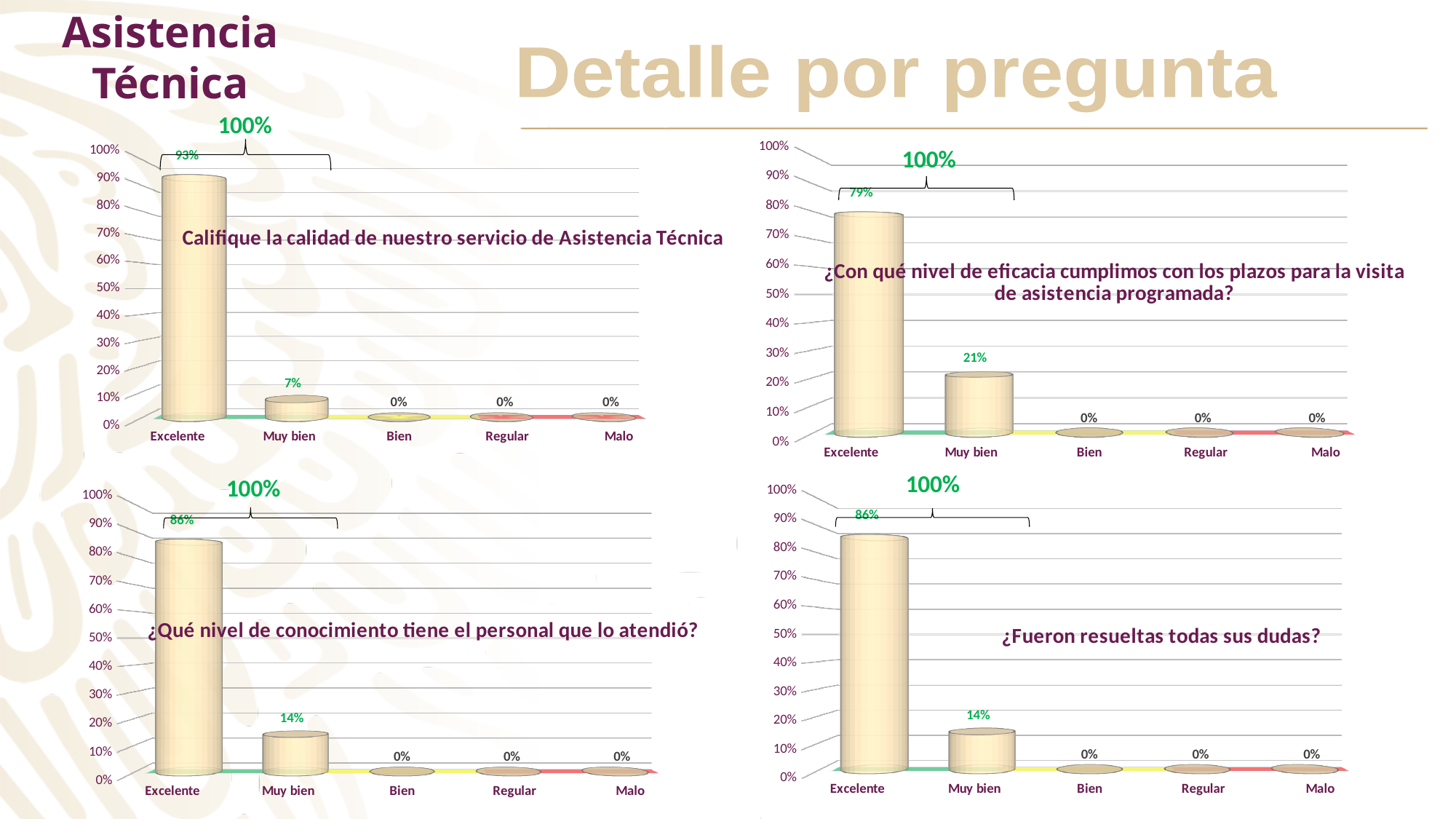
In the chart titled "¿Con qué nivel de eficacia cumplimos con los plazos para la visita de asistencia programada?", what is the value for Excelente? 79% In the chart titled "¿Con qué nivel de eficacia cumplimos con los plazos para la visita de asistencia programada?", what is the difference between the Excelente and Muy bien values? 58% In the chart titled "¿Qué nivel de conocimiento tiene el personal que lo atendió?", what is the value for Excelente? 86% In the chart titled "Califique la calidad de nuestro servicio de Asistencia Técnica", what is the value for Excelente? 93% In the chart titled "¿Qué nivel de conocimiento tiene el personal que lo atendió?", is the value for Excelente greater or less than 80%? greater What kind of chart is the chart titled "¿Qué nivel de conocimiento tiene el personal que lo atendió?"? Bar chart In the chart titled "¿Con qué nivel de eficacia cumplimos con los plazos para la visita de asistencia programada?", what is the value for Muy bien? 21% In the chart titled "¿Fueron resueltas todas sus dudas?", how many categories are shown on the x axis? 5 In the chart titled "Califique la calidad de nuestro servicio de Asistencia Técnica", which category has the highest value? Excelente In the chart titled "Califique la calidad de nuestro servicio de Asistencia Técnica", what is the value for Muy bien? 7% In the chart titled "¿Fueron resueltas todas sus dudas?", what is the value for Muy bien? 14% In the chart titled "Califique la calidad de nuestro servicio de Asistencia Técnica", what is the value for Regular? 0%